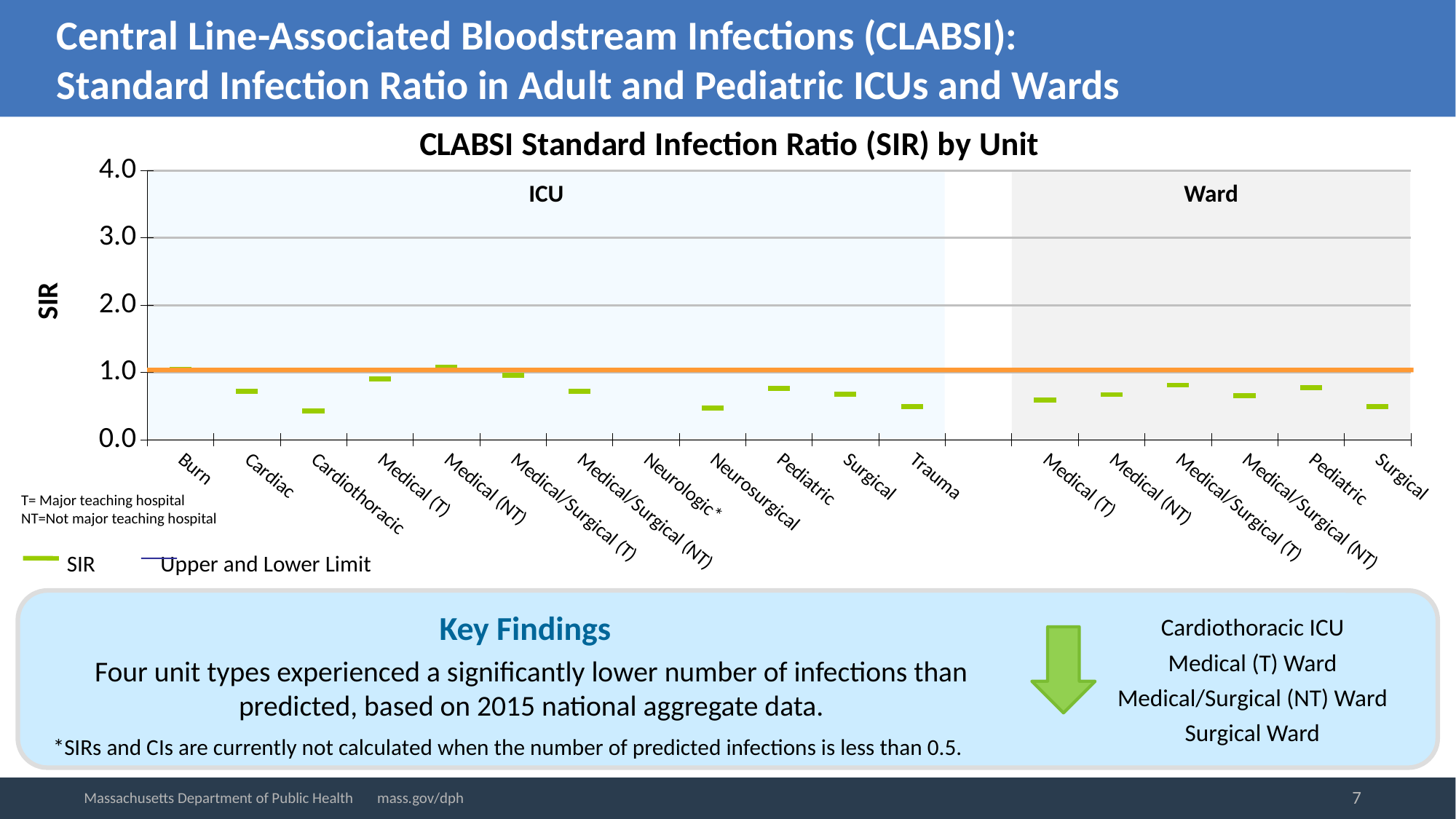
Is the SIR value for the Surgical Ward greater or less than 1.0? less How many series does the chart legend list? 2 Which has the larger SIR value: Medical/Surgical (NT) Ward or Surgical Ward? Medical/Surgical (NT) Ward What is the title of the chart? CLABSI Standard Infection Ratio (SIR) by Unit How many unit categories are in the ICU section of the chart? 12 What is the label on the y axis of the chart? SIR How many unit categories are shown on the x axis of the chart? 18 Which has the larger SIR value: Medical (NT) ICU or Cardiothoracic ICU? Medical (NT) ICU Is the SIR value for Cardiothoracic ICU greater or less than 1.0? less Is the SIR value for Trauma ICU greater or less than 1.0? less How many unit categories are in the Ward section of the chart? 6